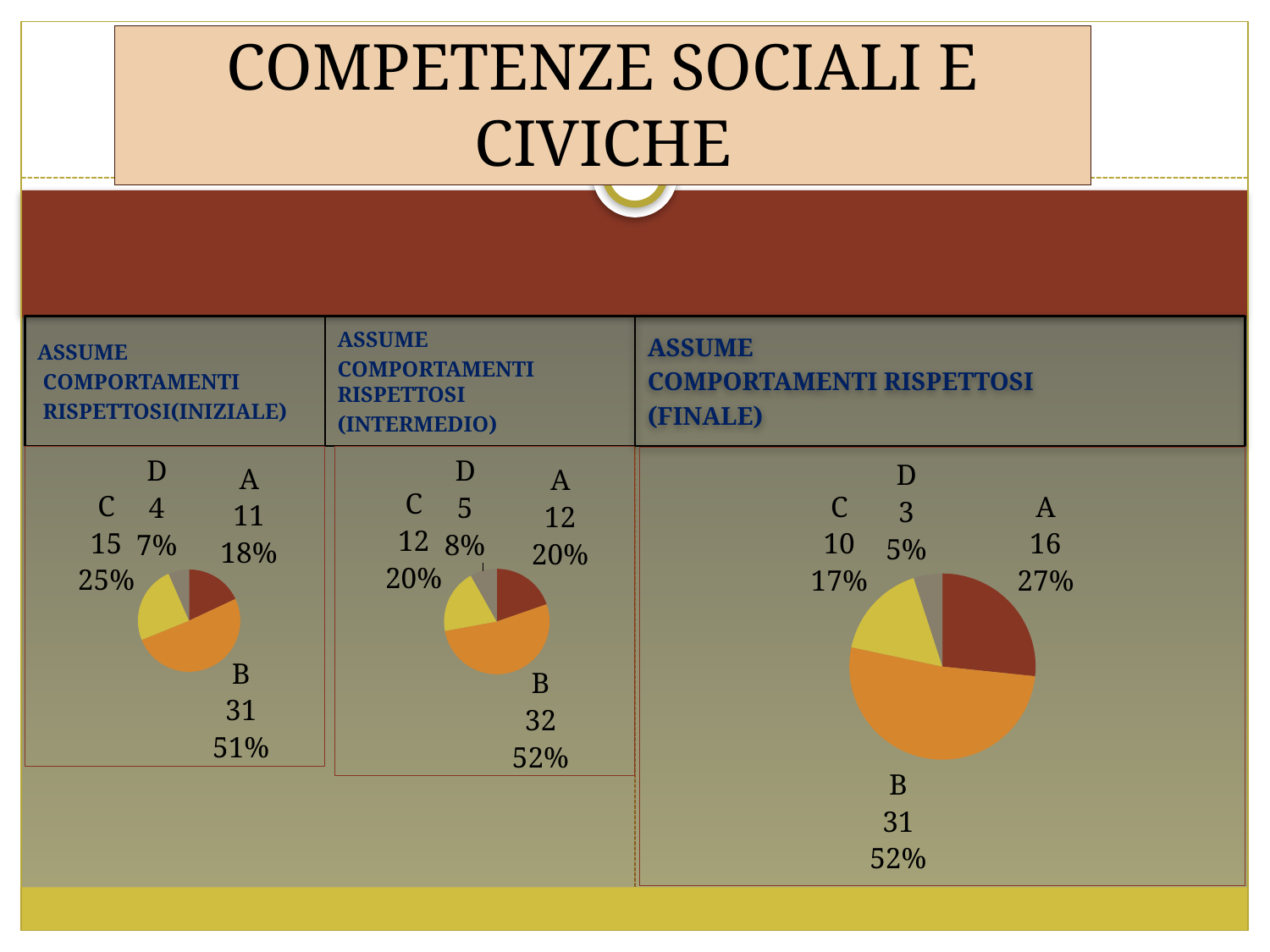
In the INTERMEDIO pie chart, what is the value for category A? 12 In the INIZIALE pie chart, which category has the lowest value? D In the FINALE pie chart, what is the value for category C? 10 In the INTERMEDIO pie chart, what percentage is shown for category D? 8% In the FINALE pie chart, what is the difference between the values for B and A? 15 In the FINALE pie chart, which is larger, the value for A or the value for C? A In the INIZIALE pie chart, what share of the pie does category C represent? 25% In the FINALE pie chart, what share of the pie does category A represent? 27% What kind of chart is used in the 'ASSUME COMPORTAMENTI RISPETTOSI (INIZIALE)' panel? Pie chart In the INIZIALE pie chart, what is the value for category B? 31 How many categories does the FINALE pie chart show? 4 In the INTERMEDIO pie chart, which category has the highest value? B